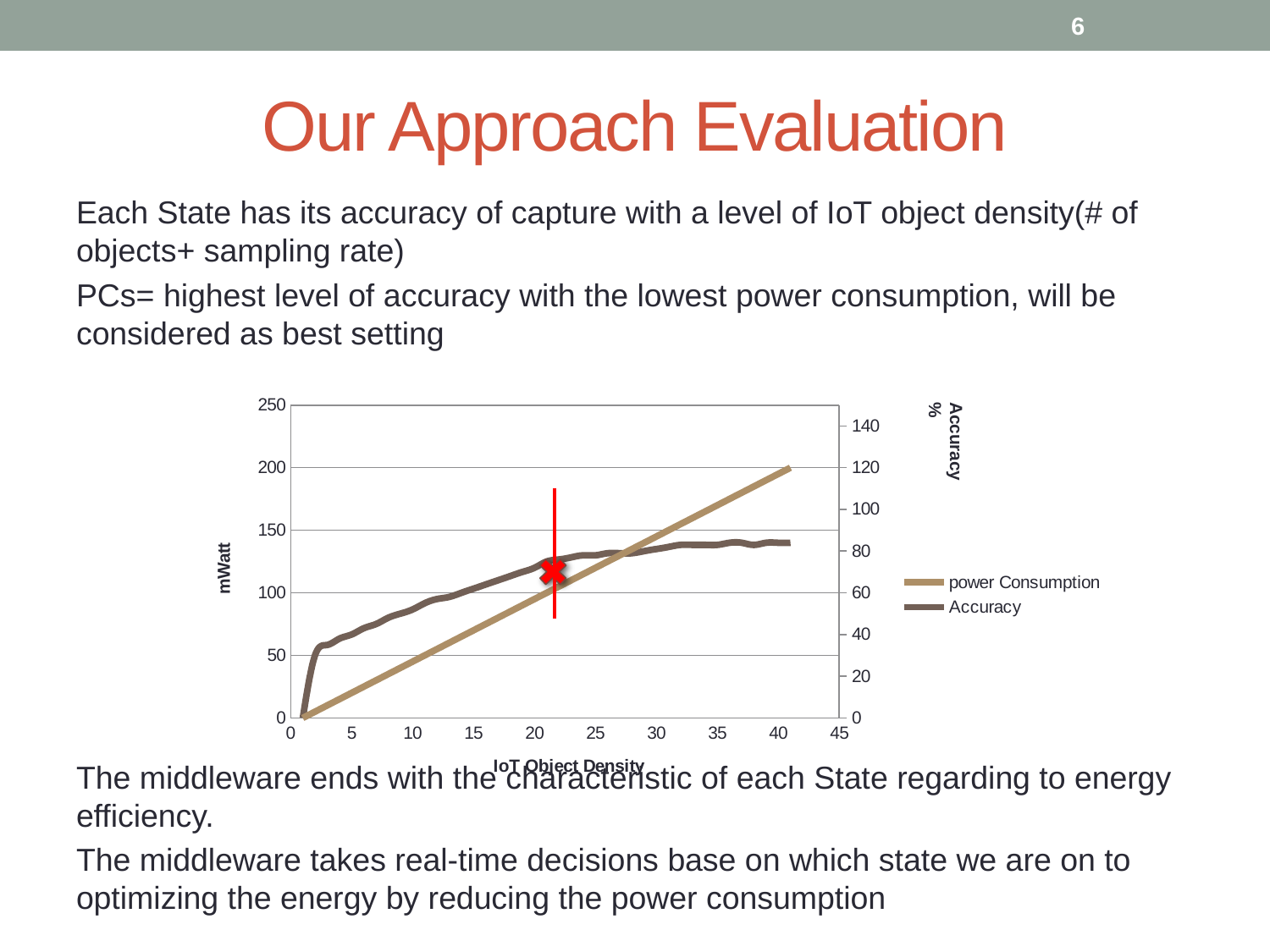
How many series does the chart legend list? 2 What is the highest tick value shown on the x axis? 45 Is the power Consumption value at an IoT Object Density of 10 greater or less than 100 mWatt? less What kind of chart is shown on the slide? line chart What is the title of the x axis of the chart? IoT Object Density Does the power Consumption line rise or fall as IoT Object Density increases? rise Is the power Consumption value at an IoT Object Density of 30 greater or less than 100 mWatt? greater What is the highest tick value shown on the right (Accuracy %) axis? 140 What is the highest tick value shown on the left (mWatt) axis? 250 Is the power Consumption value at an IoT Object Density of 40 greater or less than 150 mWatt? greater What are the two series named in the chart legend? power Consumption and Accuracy